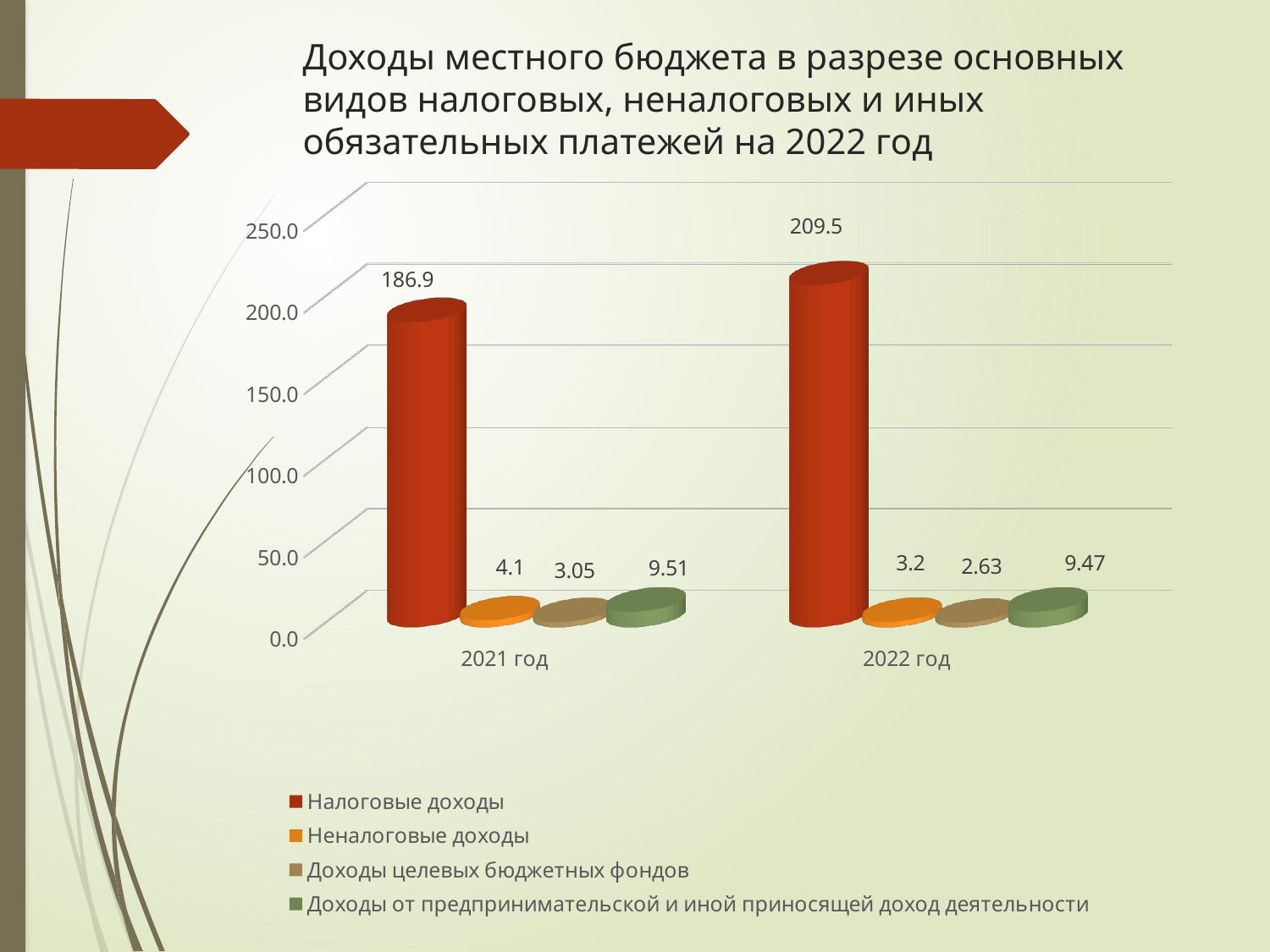
What is the value of Налоговые доходы for 2022 год? 209.5 What is the difference between Налоговые доходы in 2022 год and in 2021 год? 22.6 What is the value of Неналоговые доходы for 2022 год? 3.2 What kind of chart is shown on the slide? Bar chart Which series has the lowest value for 2021 год? Доходы целевых бюджетных фондов Which is larger: Неналоговые доходы in 2021 год or in 2022 год? 2021 год How many series does the legend list? 4 How many categories are shown on the x axis? 2 What is the value of Доходы от предпринимательской и иной приносящей доход деятельности for 2022 год? 9.47 Which series has the highest value for 2022 год? Налоговые доходы What is the value of Налоговые доходы for 2021 год? 186.9 What is the value of Доходы целевых бюджетных фондов for 2021 год? 3.05